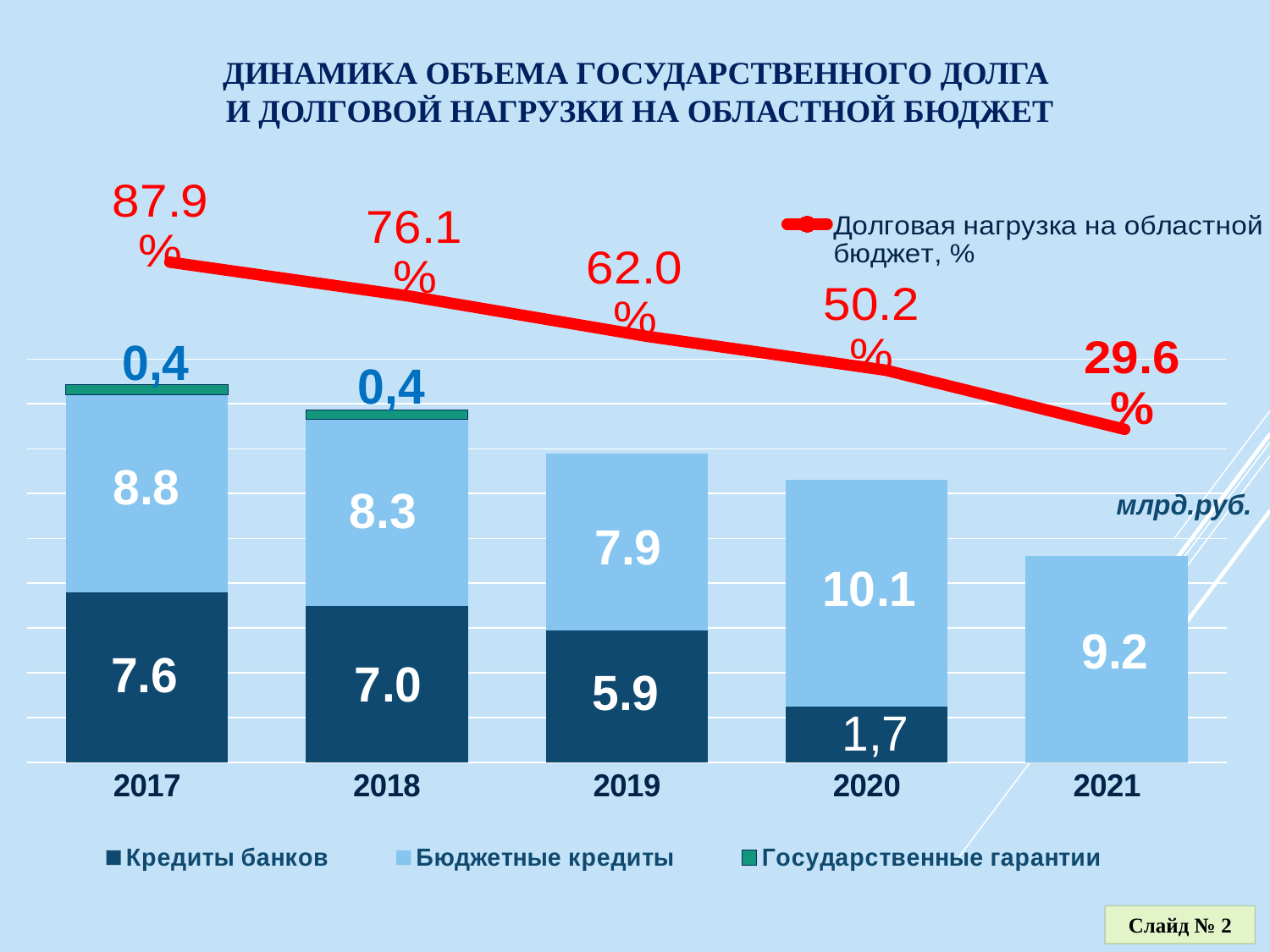
How many series does the legend at the bottom of the chart list? 3 In which year is Долговая нагрузка на областной бюджет, % the lowest? 2021 Which is larger: Бюджетные кредиты in 2018 or in 2021? 2021 What is the total of the stacked bar for 2019? 13.8 What is the value of Долговая нагрузка на областной бюджет, % for 2019? 62.0% What is the value of Кредиты банков for 2017? 7.6 In which year is Бюджетные кредиты the highest? 2020 How does Долговая нагрузка на областной бюджет, % change from 2017 to 2021? It falls How many years are shown on the x axis? 5 What is the value of Государственные гарантии for 2018? 0,4 What is the difference between Кредиты банков in 2017 and in 2019? 1.7 What is the value of Бюджетные кредиты for 2020? 10.1